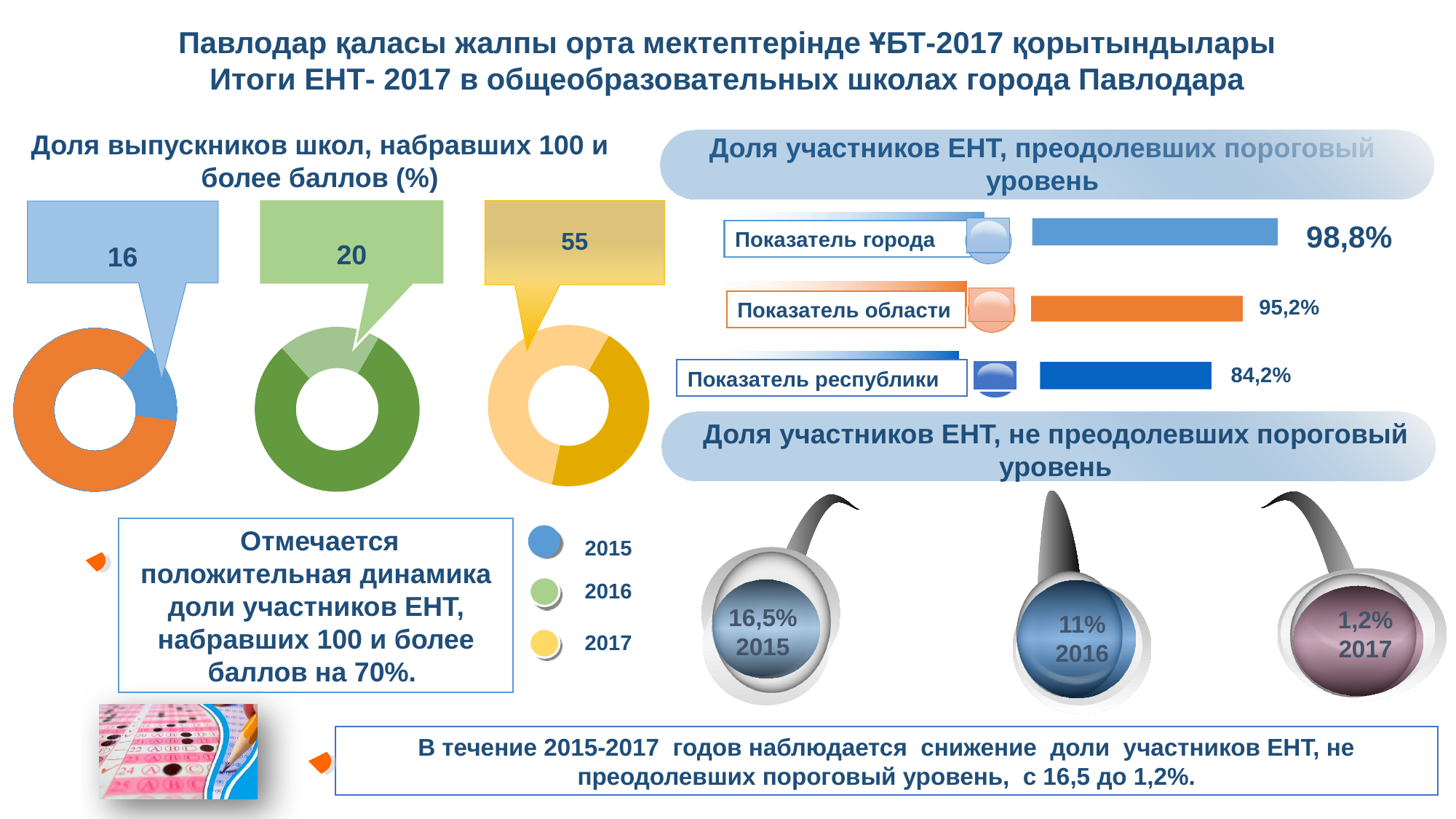
In the donut charts for the share of graduates scoring 100 or more points, do the values rise or fall from 2015 to 2017? rise How many years are listed in the legend of the donut charts for the share of graduates scoring 100 or more points? 3 In the bar chart of the share of UNT participants who passed the threshold level, what is the value for 'Показатель города'? 98,8% In the donut charts for the share of graduates scoring 100 or more points, by how much does the 2017 value exceed the 2016 value? 35 In the donut charts for the share of graduates scoring 100 or more points, what value is shown for 2017? 55 In the donut charts for the share of graduates scoring 100 or more points, what value is shown for 2016? 20 In the donut charts for the share of graduates scoring 100 or more points, which year has the highest value? 2017 In the bar chart of the share of UNT participants who passed the threshold level, what is the value for 'Показатель республики'? 84,2% In the bar chart of the share of UNT participants who passed the threshold level, what is the difference between 'Показатель города' and 'Показатель области'? 3,6% In the bar chart of the share of UNT participants who passed the threshold level, which indicator has the lowest value? Показатель республики In the donut charts for the share of graduates scoring 100 or more points, which year has the lowest value? 2015 In the donut charts for the share of graduates scoring 100 or more points, what value is shown for 2015? 16